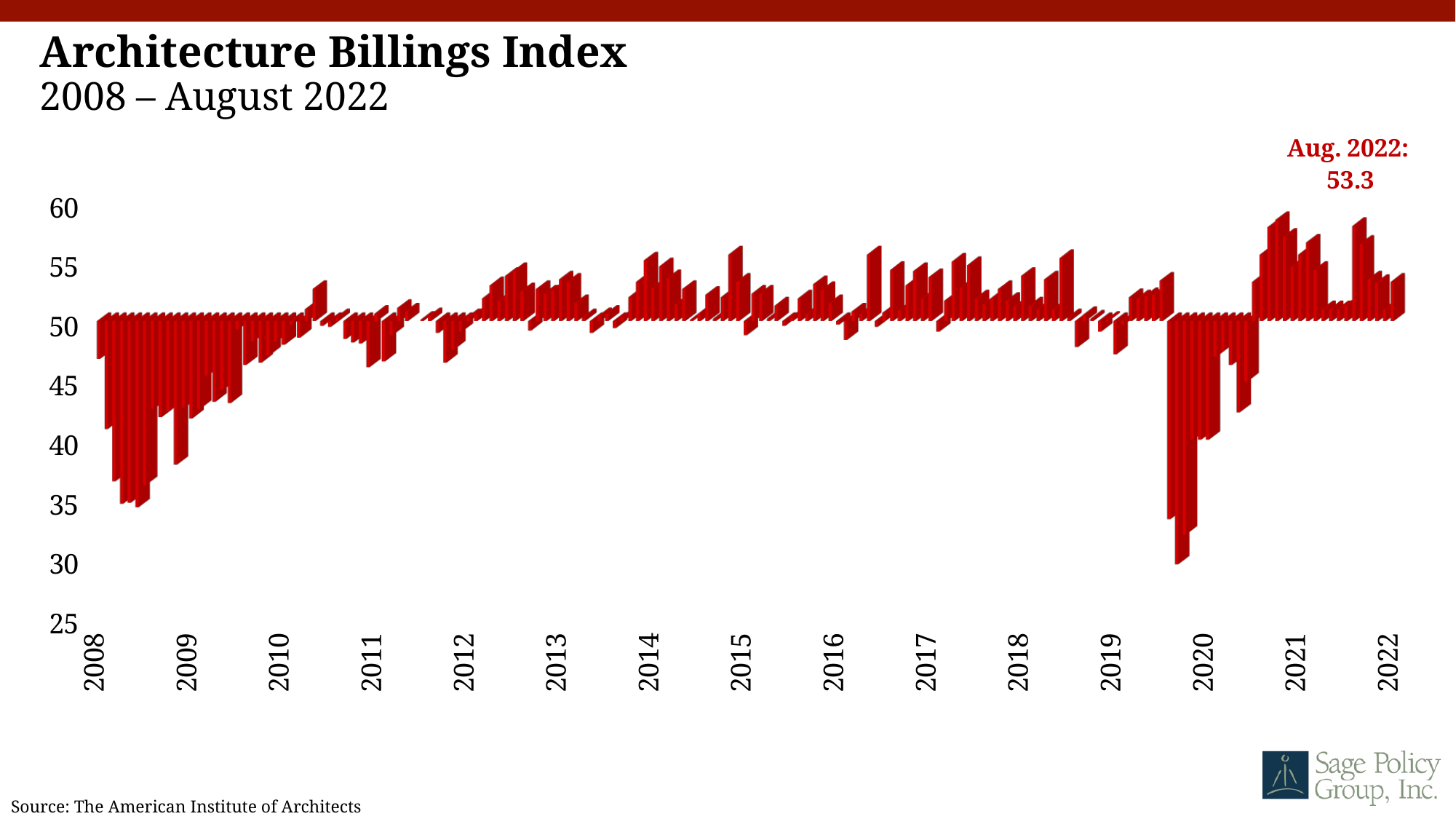
Is the lowest value shown in 2020 greater or less than 35? less In which year does the chart reach its lowest value? 2020 What is the source cited for the chart? The American Institute of Architects What is the title of the chart? Architecture Billings Index Is the lowest value shown in 2008 greater or less than 40? less Which is lower, the lowest value in 2008 or the lowest value in 2020? 2020 What is the value of the Architecture Billings Index for Aug. 2022? 53.3 Is the value for Aug. 2022 greater or less than 50? greater How many year labels are shown on the x axis? 15 What kind of chart is used to show the Architecture Billings Index? bar chart